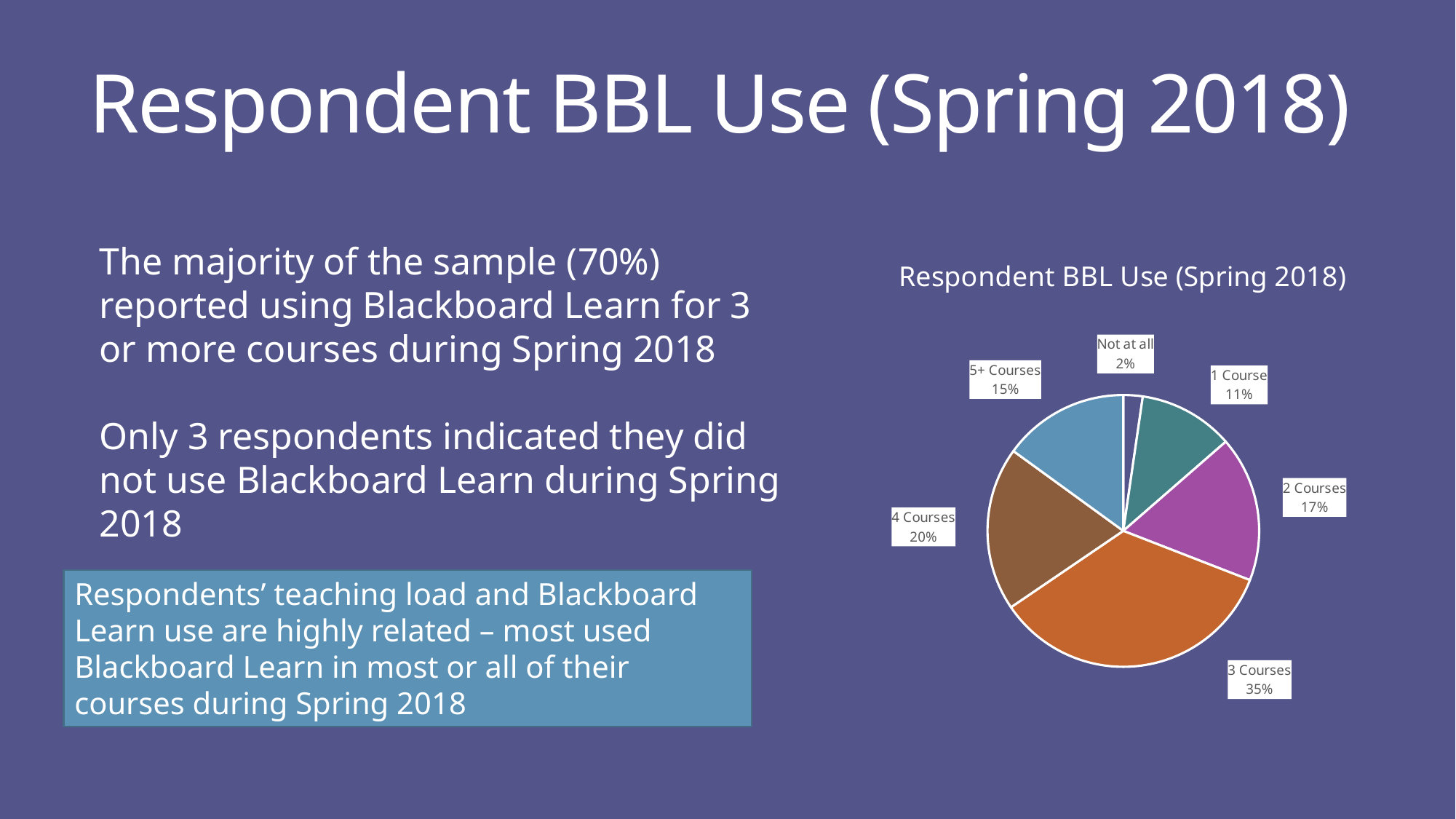
Which is larger, the share for 1 Course or the share for 2 Courses? 2 Courses What share of respondents used Blackboard Learn for 4 Courses? 20% What type of chart is shown on the slide? pie chart What is the difference in percentage points between 3 Courses and 2 Courses? 18 What share of respondents did not use Blackboard Learn at all? 2% What is the combined share of respondents using Blackboard Learn for 3, 4, or 5+ Courses? 70% What share of respondents used Blackboard Learn for 3 Courses? 35% Which category has the largest slice of the pie? 3 Courses What is the title of the chart? Respondent BBL Use (Spring 2018) Which category has the smallest slice of the pie? Not at all How many categories are shown in the pie chart? 6 What share of respondents used Blackboard Learn for 5+ Courses? 15%